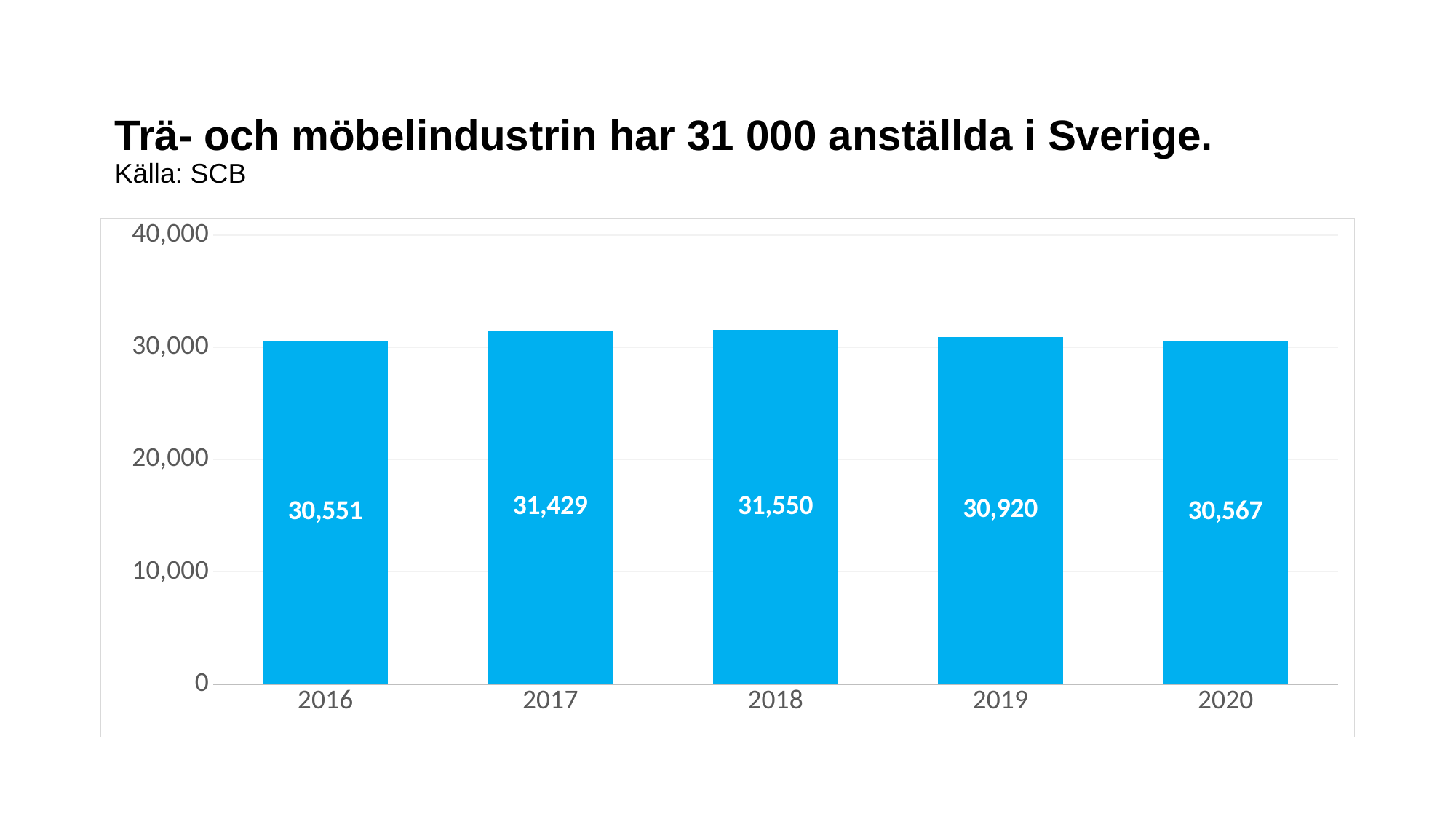
Which year has the highest value? 2018 What is the difference between the values for 2017 and 2019? 509 What kind of chart is shown on the slide? bar chart What is the value for 2016? 30,551 How many years are shown on the x axis? 5 What is the difference between the values for 2018 and 2016? 999 What is the source cited below the slide title? SCB What is the value for 2018? 31,550 What is the value for 2020? 30,567 Which year has the lowest value? 2016 Which is larger, the value for 2017 or the value for 2019? 2017 Is the value for 2019 greater or less than 30,000? greater